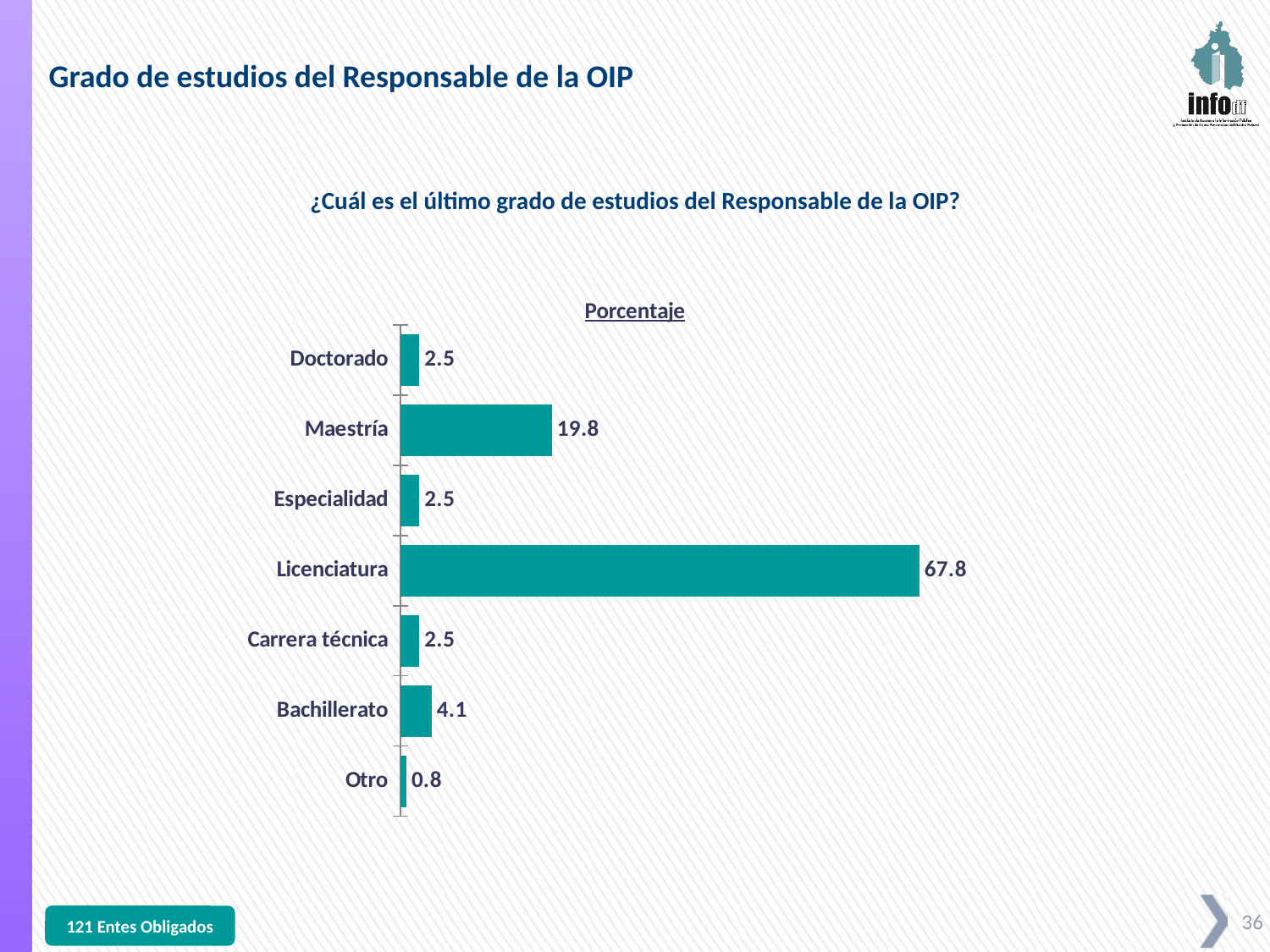
Which is larger, the value for Maestría or the value for Bachillerato? Maestría How many categories are shown in the chart? 7 Which category has the lowest value? Otro What is the title of the chart? Porcentaje What is the value for Licenciatura? 67.8 What is the value for Bachillerato? 4.1 What is the difference between the values for Bachillerato and Otro? 3.3 What kind of chart is shown on the slide? Bar chart What is the value for Maestría? 19.8 What is the value for Otro? 0.8 What is the difference between the values for Licenciatura and Maestría? 48 Which category has the highest value? Licenciatura